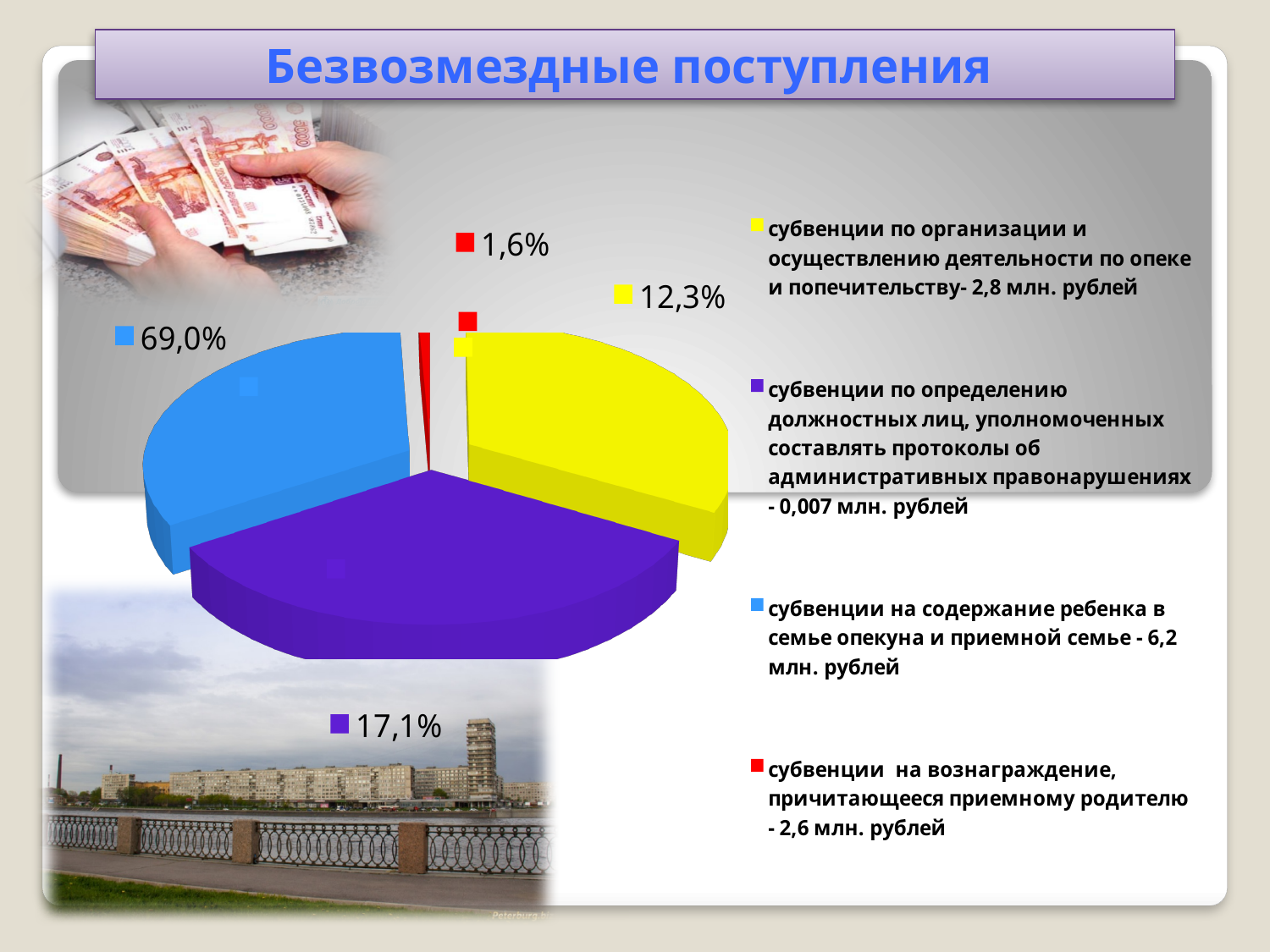
What kind of chart is shown on the slide? pie chart Which is larger, the yellow slice or the purple slice? the purple slice What is the title of the slide containing the pie chart? Безвозмездные поступления According to the legend, how many million rubles are the subsidies for the maintenance of a child in a guardian's family and foster family (субвенции на содержание ребенка в семье опекуна и приемной семье)? 6,2 млн. рублей Which slice of the pie chart has the smallest share? the red slice (1,6%) What is the difference in percentage points between the blue slice (69,0%) and the purple slice (17,1%)? 51,9 Which slice of the pie chart has the largest share? the blue slice (69,0%) How many slices does the pie chart have? 4 What percentage is shown for the yellow slice of the pie chart? 12,3% What percentage is shown for the blue slice of the pie chart? 69,0% What percentage is shown for the red slice of the pie chart? 1,6% What percentage is shown for the purple slice of the pie chart? 17,1%